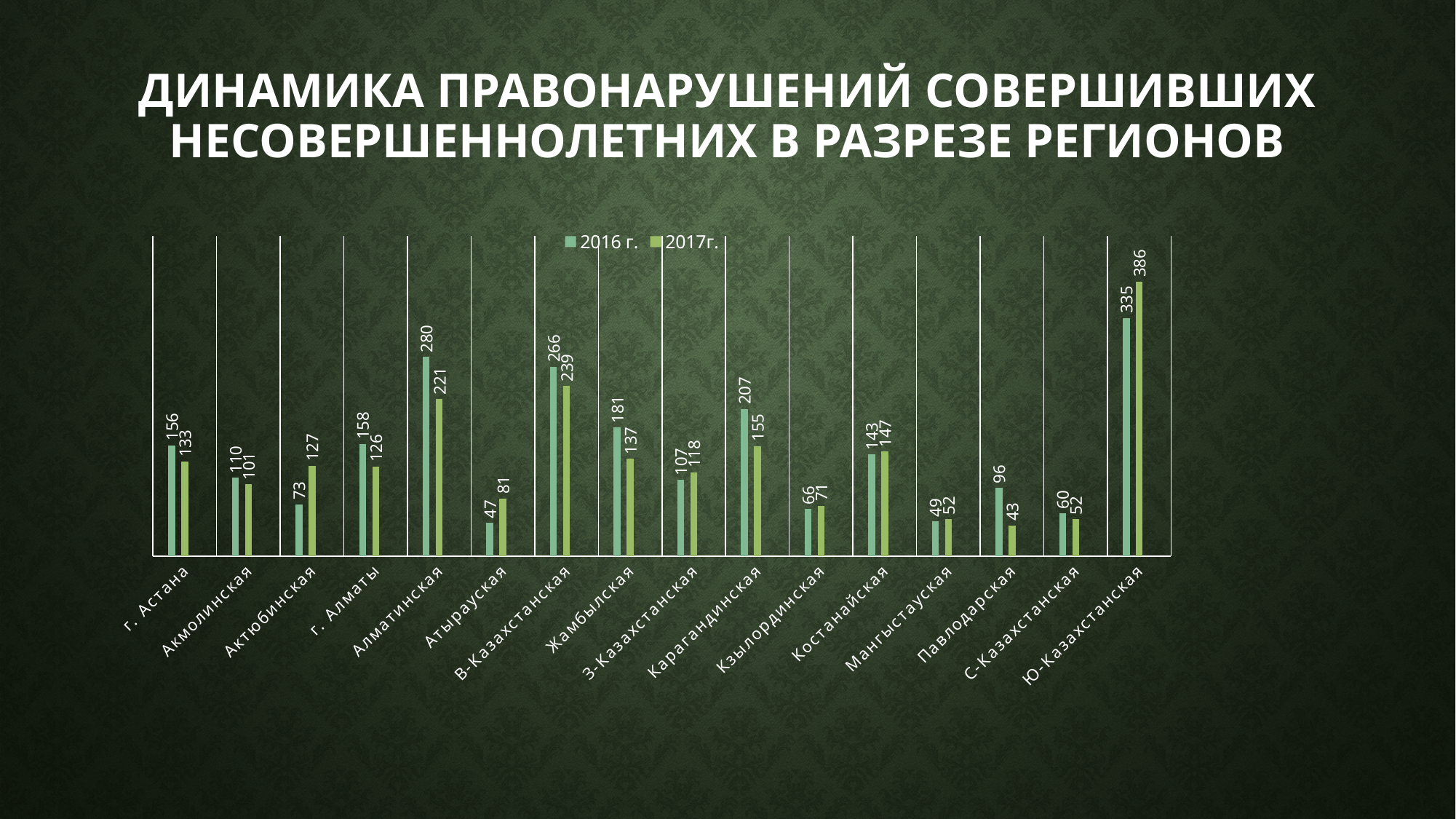
Which is larger for Жамбылская: the 2016 г. value or the 2017г. value? 2016 г. What kind of chart is shown on the slide? Bar chart What is the difference between the 2016 г. and 2017г. values for Карагандинская? 52 What is the value for Актюбинская in 2017г.? 127 Which region has the highest value in 2017г.? Ю-Казахстанская Which region has the lowest value in 2016 г.? Атырауская How many series does the legend list? 2 What is the value for Павлодарская in 2017г.? 43 What is the difference between the 2017г. and 2016 г. values for Ю-Казахстанская? 51 How many regions are shown on the x axis? 16 Which is larger for Атырауская: the 2016 г. value or the 2017г. value? 2017г. What is the value for Алматинская in 2016 г.? 280